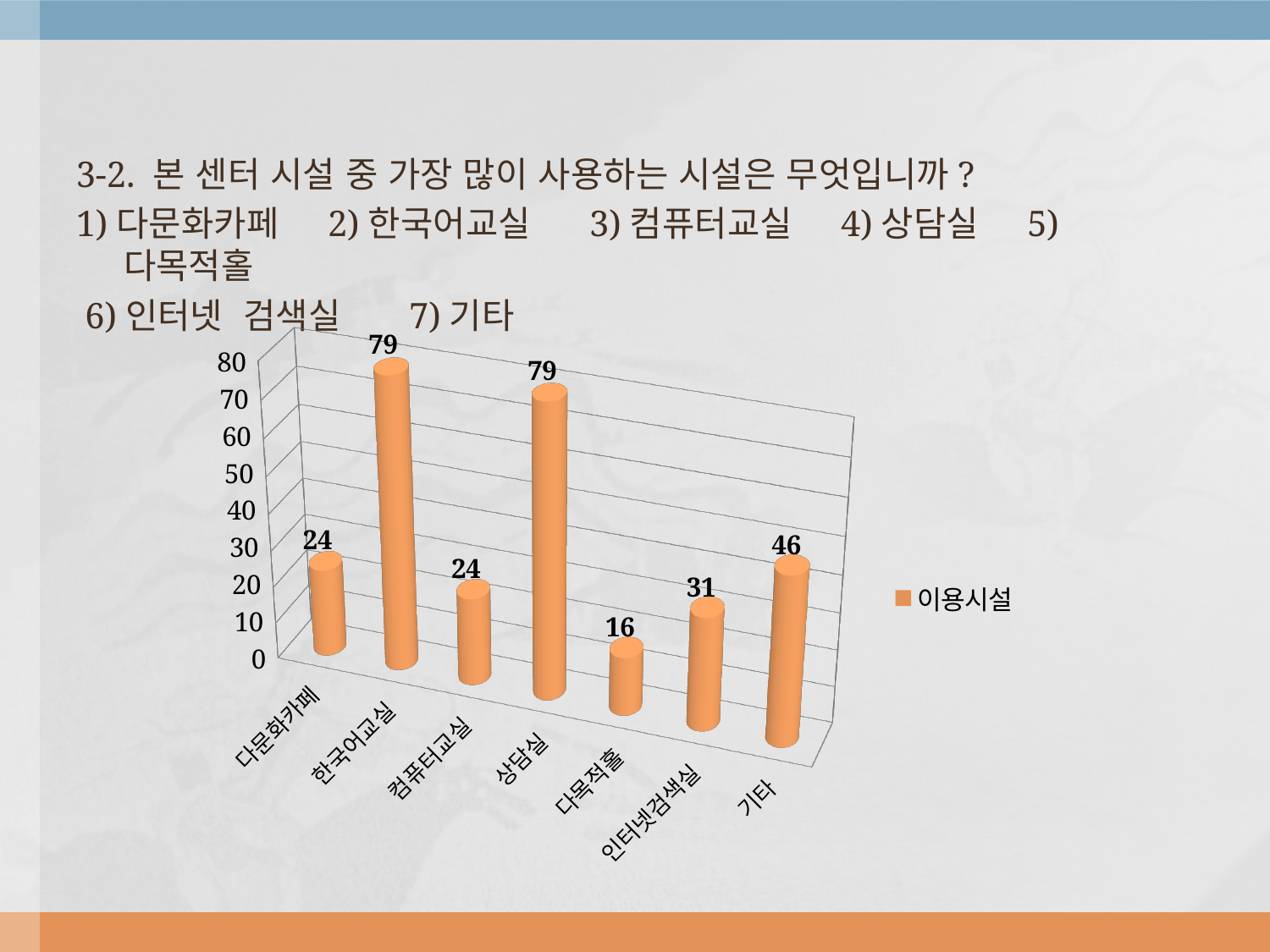
What is the value for 기타? 46 Which category has the lowest value? 다목적홀 How many categories are shown on the x axis? 7 What is the value for 한국어교실? 79 What is the difference between the values for 기타 and 인터넷검색실? 15 What is the value for 인터넷검색실? 31 What is the value for 다문화카페? 24 What is the value for 다목적홀? 16 What is the series name shown in the legend? 이용시설 Which is larger, the value for 상담실 or the value for 기타? 상담실 What kind of chart is shown on the slide? bar chart What is the highest value shown in the chart? 79